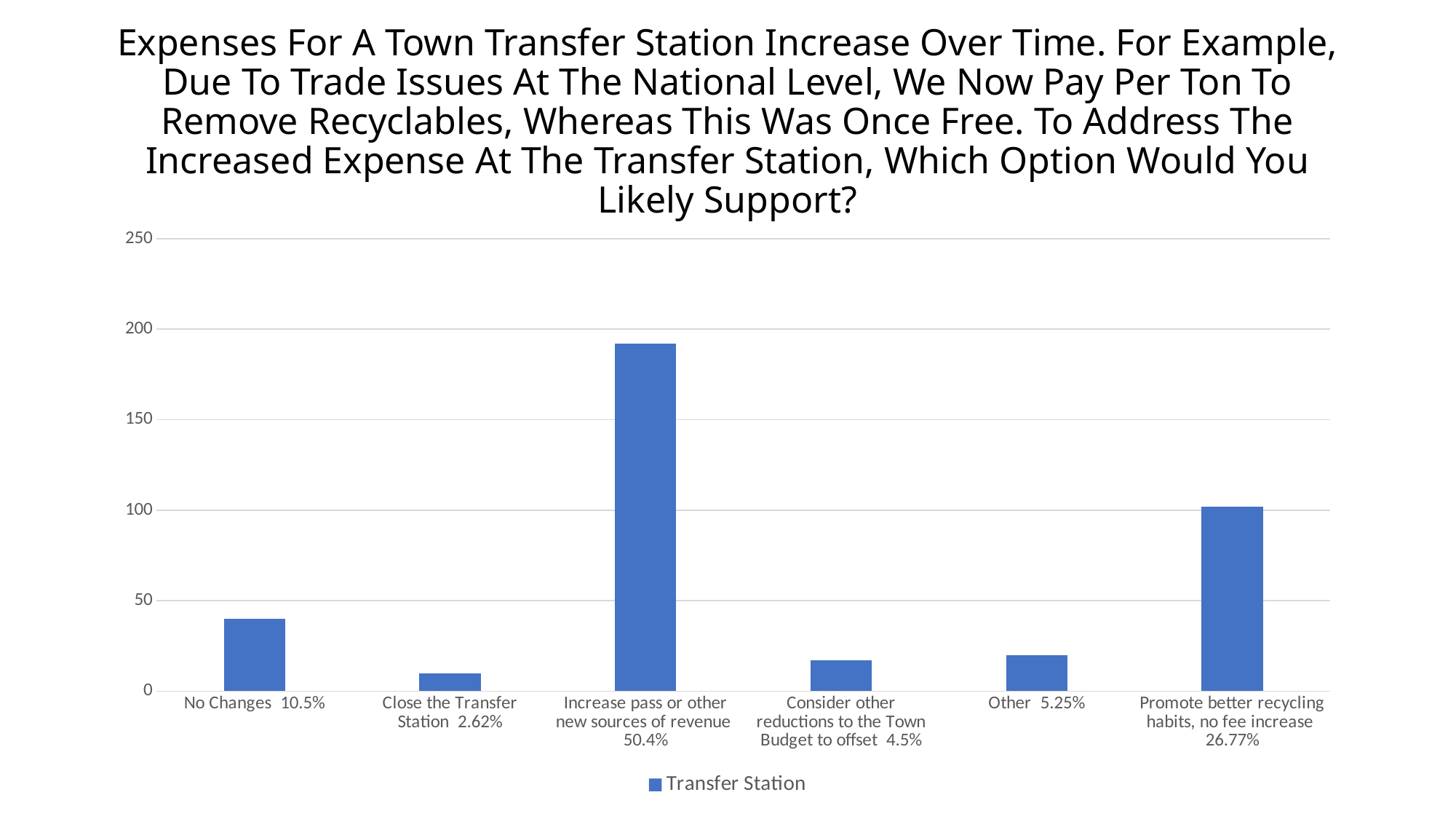
Is the value for 'No Changes' greater or less than 50? less What is the name of the series shown in the legend? Transfer Station Which category has the highest bar? Increase pass or other new sources of revenue How many categories are shown on the x axis of the chart? 6 Which category has the lowest bar? Close the Transfer Station Is the value for 'Increase pass or other new sources of revenue' greater or less than 150? greater Is the value for 'Promote better recycling habits, no fee increase' greater or less than 50? greater Which bar is taller: 'No Changes' or 'Other'? No Changes What kind of chart is shown on the slide? bar chart How many series does the legend list? 1 What percentage is printed in the category label for 'Increase pass or other new sources of revenue'? 50.4% What percentage is printed in the category label for 'Promote better recycling habits, no fee increase'? 26.77%